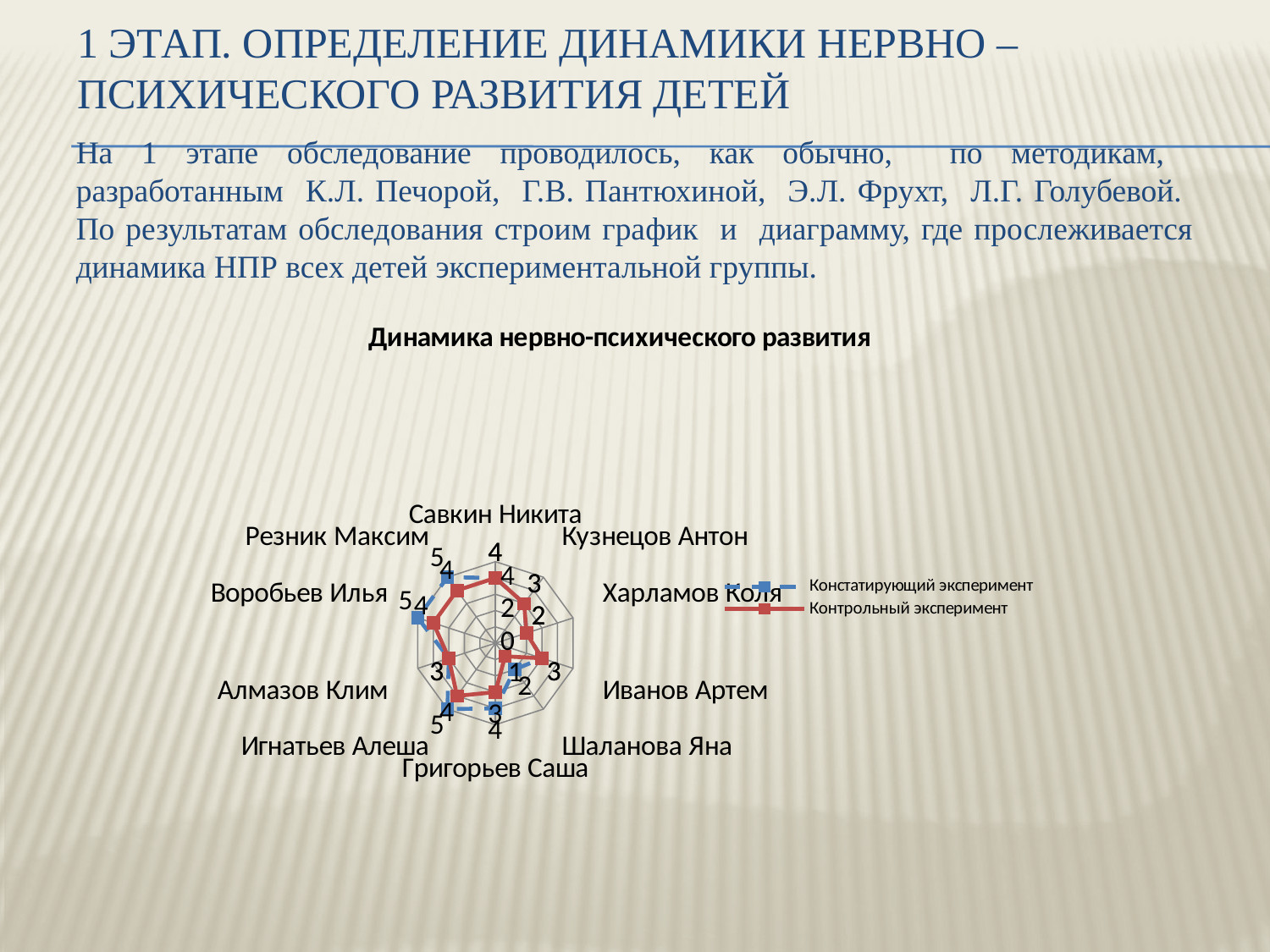
For Воробьев Илья, which series has the larger value: Констатирующий эксперимент or Контрольный эксперимент? Констатирующий эксперимент How many children (categories) are plotted on the radar chart? 10 How many series does the chart legend list? 2 What kind of chart is shown on the slide? radar chart What is the title of the chart? Динамика нервно-психического развития What are the two series named in the chart legend? Констатирующий эксперимент and Контрольный эксперимент